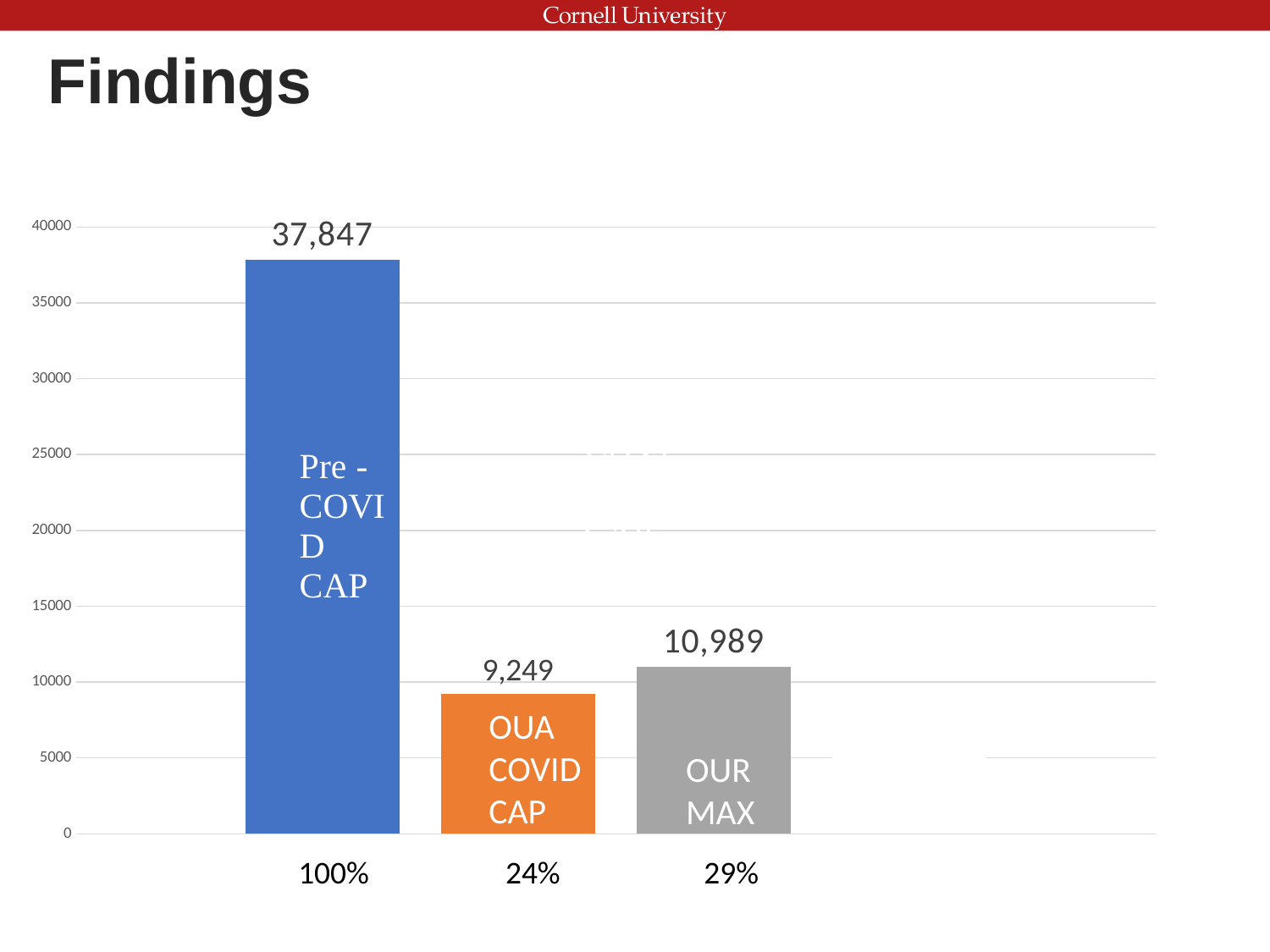
Which bar has the lowest value? OUA COVID CAP Is the value for OUA COVID CAP greater or less than 10000? less What is the difference between the OUR MAX value and the OUA COVID CAP value? 1,740 What kind of chart is shown on the slide? bar chart Which bar has the highest value? Pre-COVID CAP What is the value shown for the OUR MAX bar? 10,989 What is the value shown for the Pre-COVID CAP bar? 37,847 What percentage label appears below the OUR MAX bar? 29% Which is larger, the OUR MAX bar or the OUA COVID CAP bar? OUR MAX How many bars are shown in the chart? 3 What is the difference between the Pre-COVID CAP value and the OUR MAX value? 26,858 What is the value shown for the OUA COVID CAP bar? 9,249